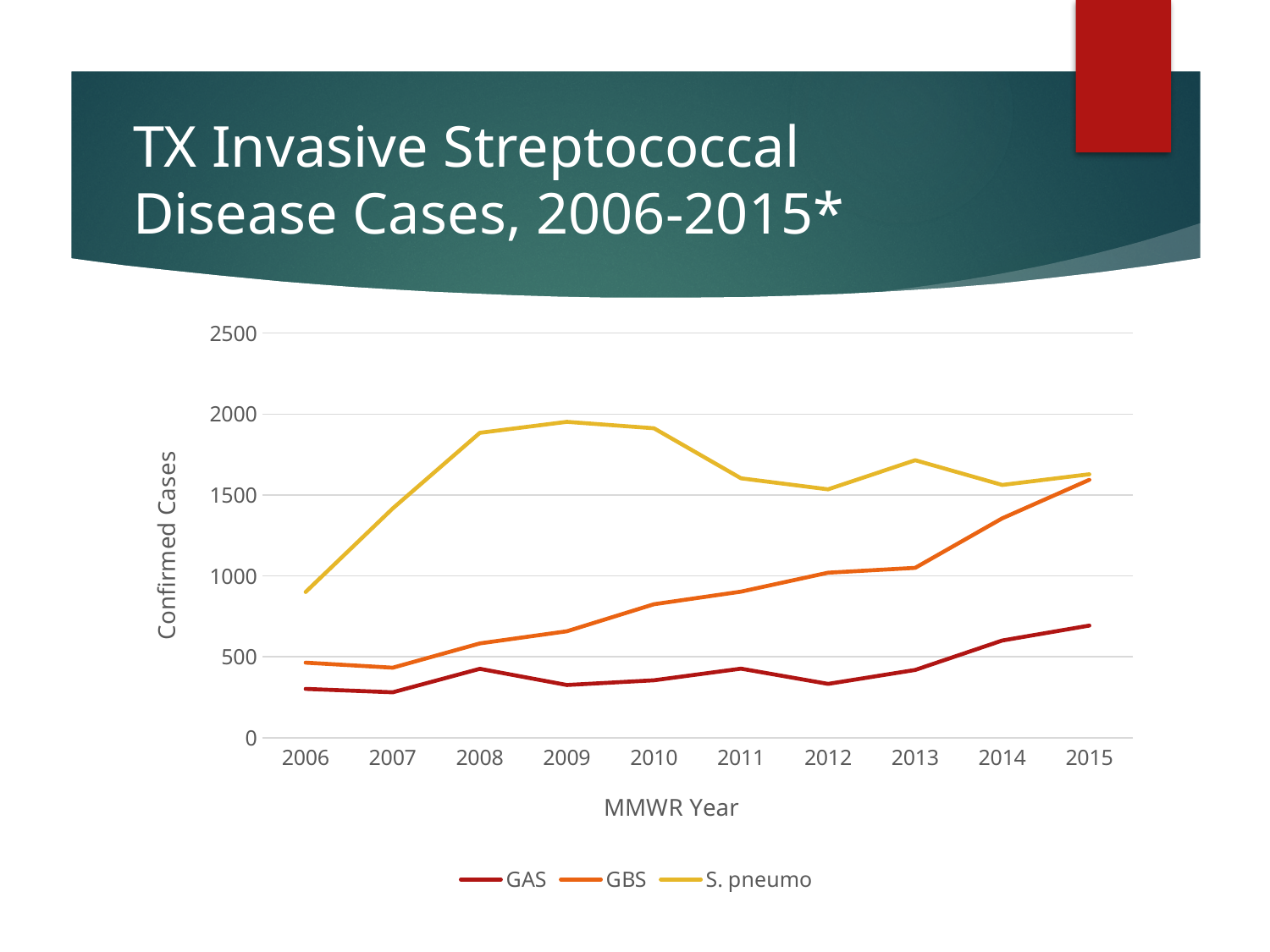
What is the label on the x axis? MMWR Year Is the value for S. pneumo in 2006 greater or less than 1000? less In which year is the GBS series at its highest? 2015 Which is larger in 2010, the GBS value or the GAS value? GBS Does the GBS series generally rise or fall from 2006 to 2015? rise Is the value for GBS in 2015 greater or less than 1500? greater How many years are plotted along the x axis? 10 What kind of chart is shown on the slide? line chart Which series has the highest value in 2008? S. pneumo In which year is the S. pneumo series at its lowest? 2006 Is the value for GAS in 2015 greater or less than 500? greater How many series does the legend list? 3